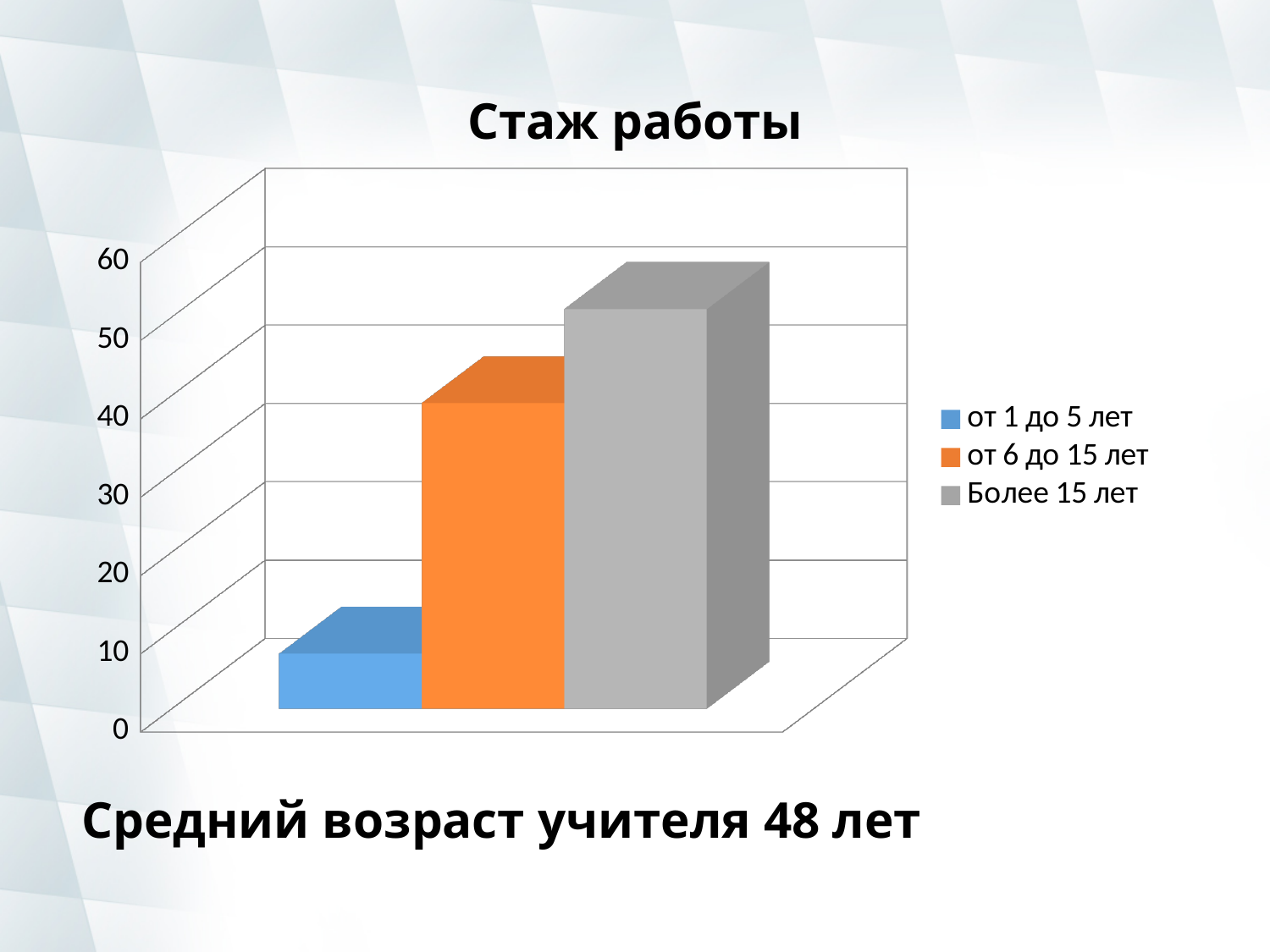
Is the value for "от 6 до 15 лет" greater or less than 30? greater How many bars are plotted in the chart? 3 Which is larger, the value for "Более 15 лет" or the value for "от 6 до 15 лет"? Более 15 лет What kind of chart is shown on the slide? bar chart Which category has the highest bar? Более 15 лет Is the value for "от 1 до 5 лет" greater or less than 20? less What colour is the bar for "Более 15 лет"? gray Is the value for "Более 15 лет" greater or less than 40? greater What is the title of the chart? Стаж работы Which category has the lowest bar? от 1 до 5 лет How many series does the legend list? 3 Which is larger, the value for "от 6 до 15 лет" or the value for "от 1 до 5 лет"? от 6 до 15 лет